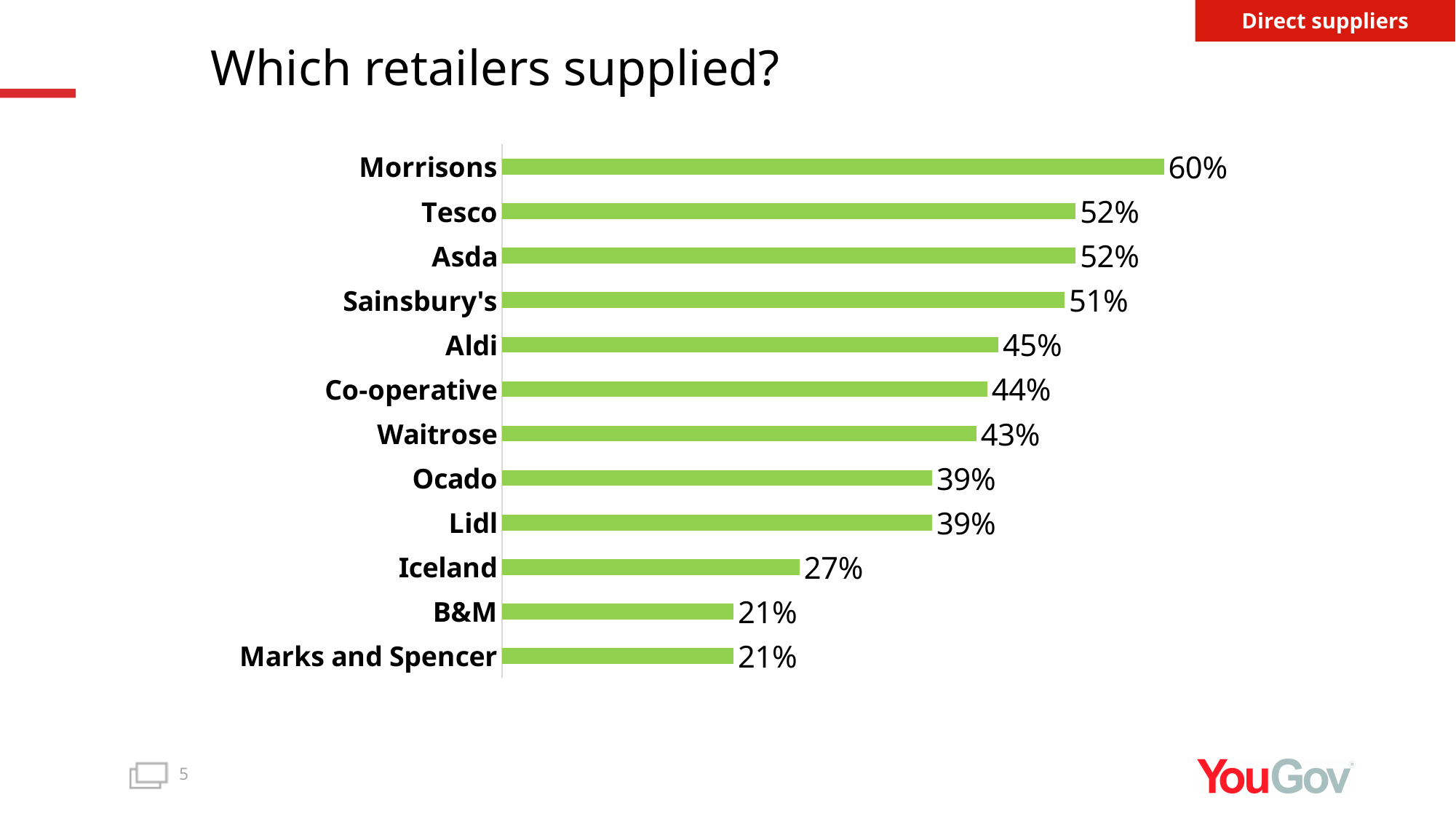
What is the difference between the values for Aldi and Iceland? 18% What is the value for Morrisons? 60% What is the title of the slide? Which retailers supplied? What is the value for Iceland? 27% How many retailers are shown in the chart? 12 Which has a larger value, Sainsbury's or Lidl? Sainsbury's What is the value for Co-operative? 44% What colour are the bars in the chart? Green What kind of chart is shown on the slide? Bar chart Which retailer has the highest value? Morrisons Which has a larger value, Waitrose or Ocado? Waitrose What is the difference between the values for Morrisons and Tesco? 8%